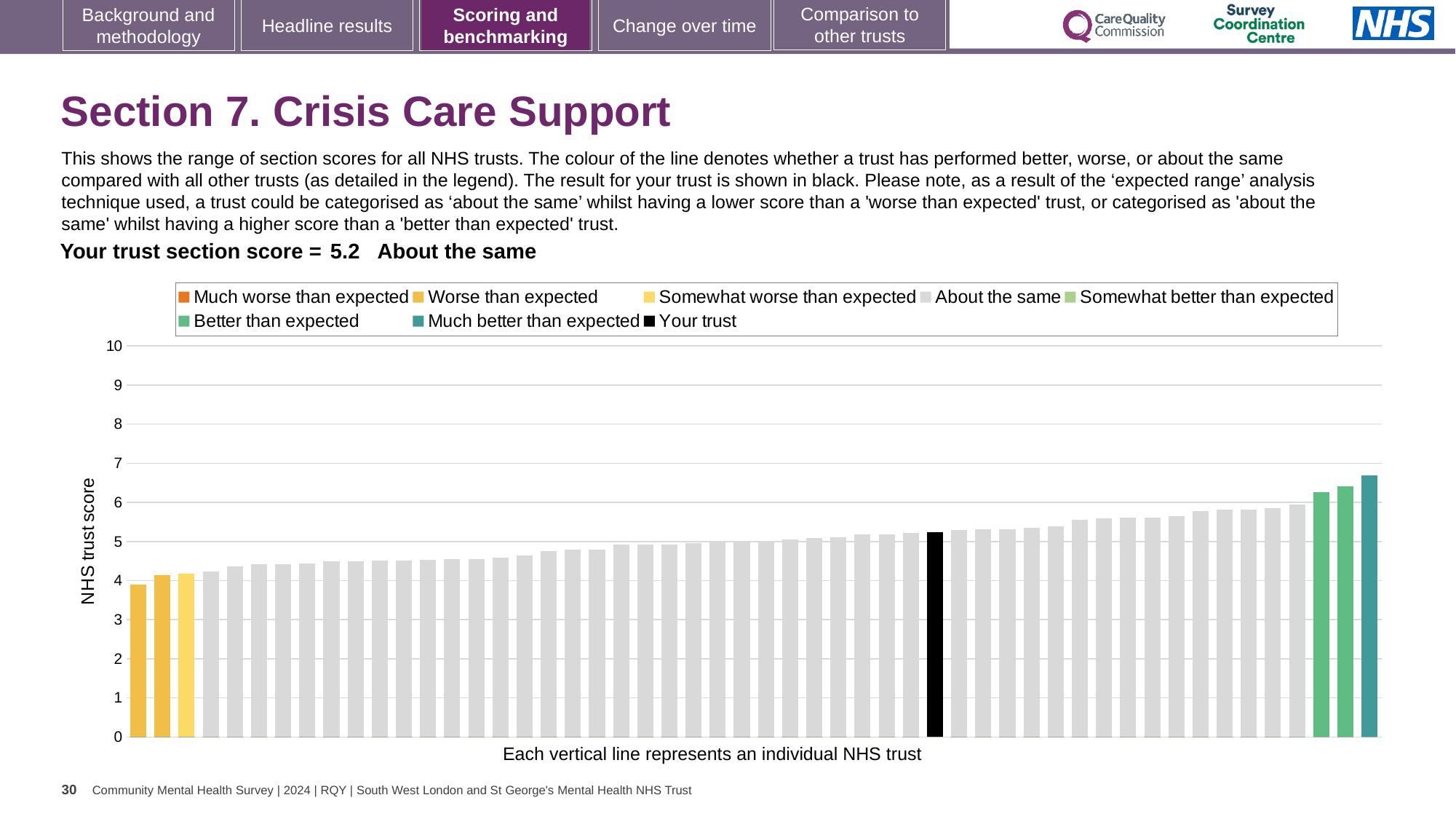
Is the lowest bar on the chart greater or less than 5? less What is the label on the vertical axis of the chart? NHS trust score Is the highest bar on the chart greater or less than 6? greater Do the bar values rise or fall from left to right along the x axis? rise Which performance category is your trust placed in according to the slide? About the same What is the section score for your trust shown on the slide? 5.2 How many entries does the chart legend list? 8 What kind of chart is shown on the slide? bar chart Is the value for your trust greater or less than 5? greater What is the maximum value shown on the vertical axis? 10 What colour is the bar representing your trust? black